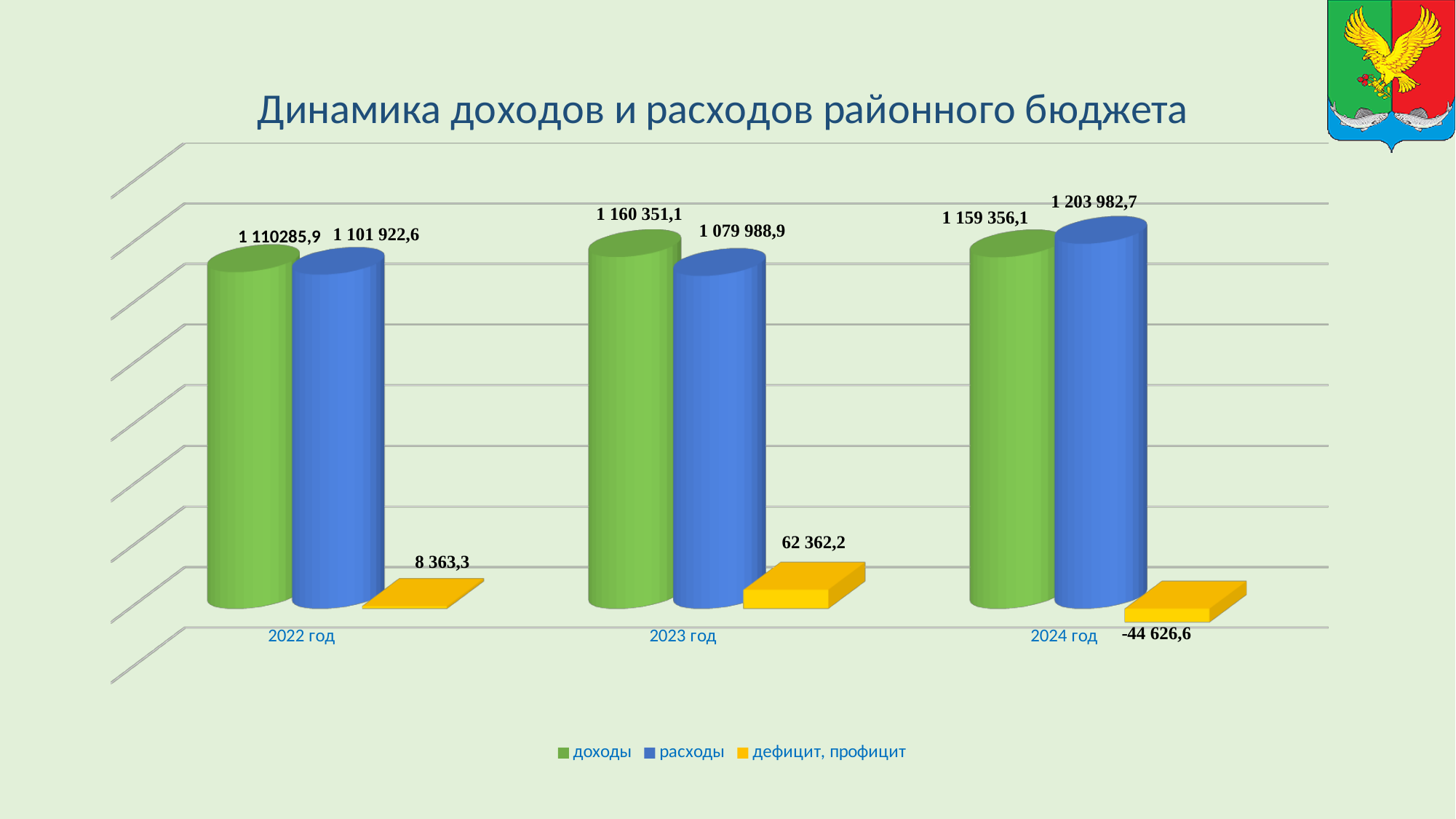
How many years are shown on the x axis? 3 What is the value of доходы for 2023 год? 1 160 351,1 Which is larger in 2023 год, доходы or расходы? доходы What is the value of дефицит, профицит for 2022 год? 8 363,3 What is the value of расходы for 2022 год? 1 101 922,6 How many series does the legend list? 3 What is the difference between расходы and доходы in 2024 год? 44 626,6 What is the value of расходы for 2024 год? 1 203 982,7 What type of chart is shown on the slide? bar chart In which year is расходы the highest? 2024 год In which year is расходы the lowest? 2023 год In which year is дефицит, профицит the lowest? 2024 год